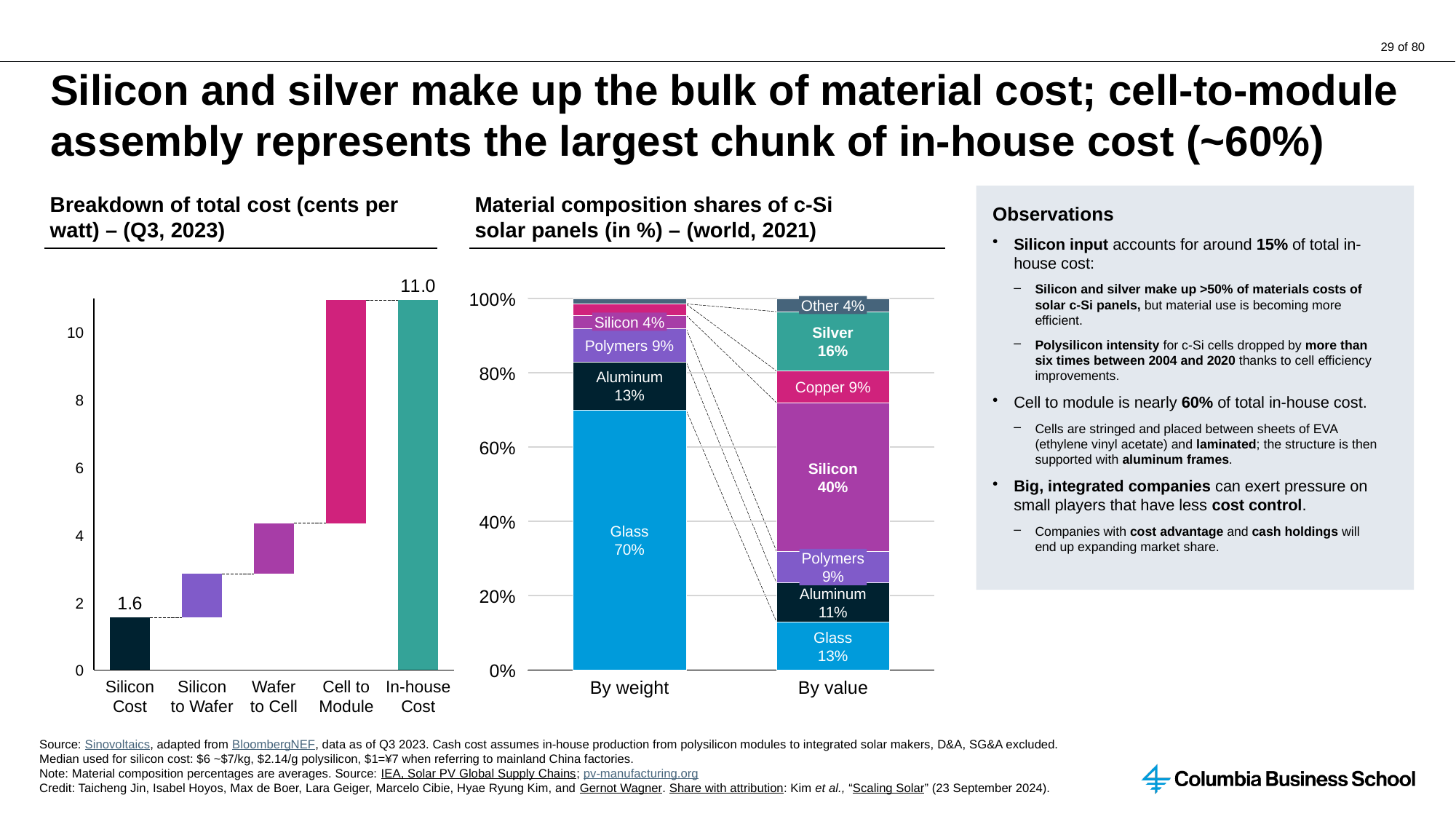
In the 'Material composition shares of c-Si solar panels' chart, what share does Silicon have in the By value bar? 40% In the 'Material composition shares of c-Si solar panels' chart, is the Glass share larger By weight or By value? By weight What kind of chart is the 'Breakdown of total cost (cents per watt)' chart? Bar chart (waterfall) In the 'Material composition shares of c-Si solar panels' chart, which segment is the largest in the By value bar? Silicon In the 'Breakdown of total cost (cents per watt)' chart, what is the difference between the In-house Cost and the Silicon Cost? 9.4 In the 'Breakdown of total cost (cents per watt)' chart, what is the value shown for In-house Cost? 11.0 How many categories are shown on the x axis of the 'Breakdown of total cost (cents per watt)' chart? 5 In the 'Material composition shares of c-Si solar panels' chart, what share does Silver have in the By value bar? 16% In the 'Breakdown of total cost (cents per watt)' chart, what is the value shown for Silicon Cost? 1.6 In the 'Material composition shares of c-Si solar panels' chart, how many percentage points higher is the Silicon share By value than By weight? 36 In the 'Material composition shares of c-Si solar panels' chart, what share does Glass have in the By weight bar? 70% In the 'Breakdown of total cost (cents per watt)' chart, does the top of the Wafer to Cell bar lie above or below 6 on the axis? below